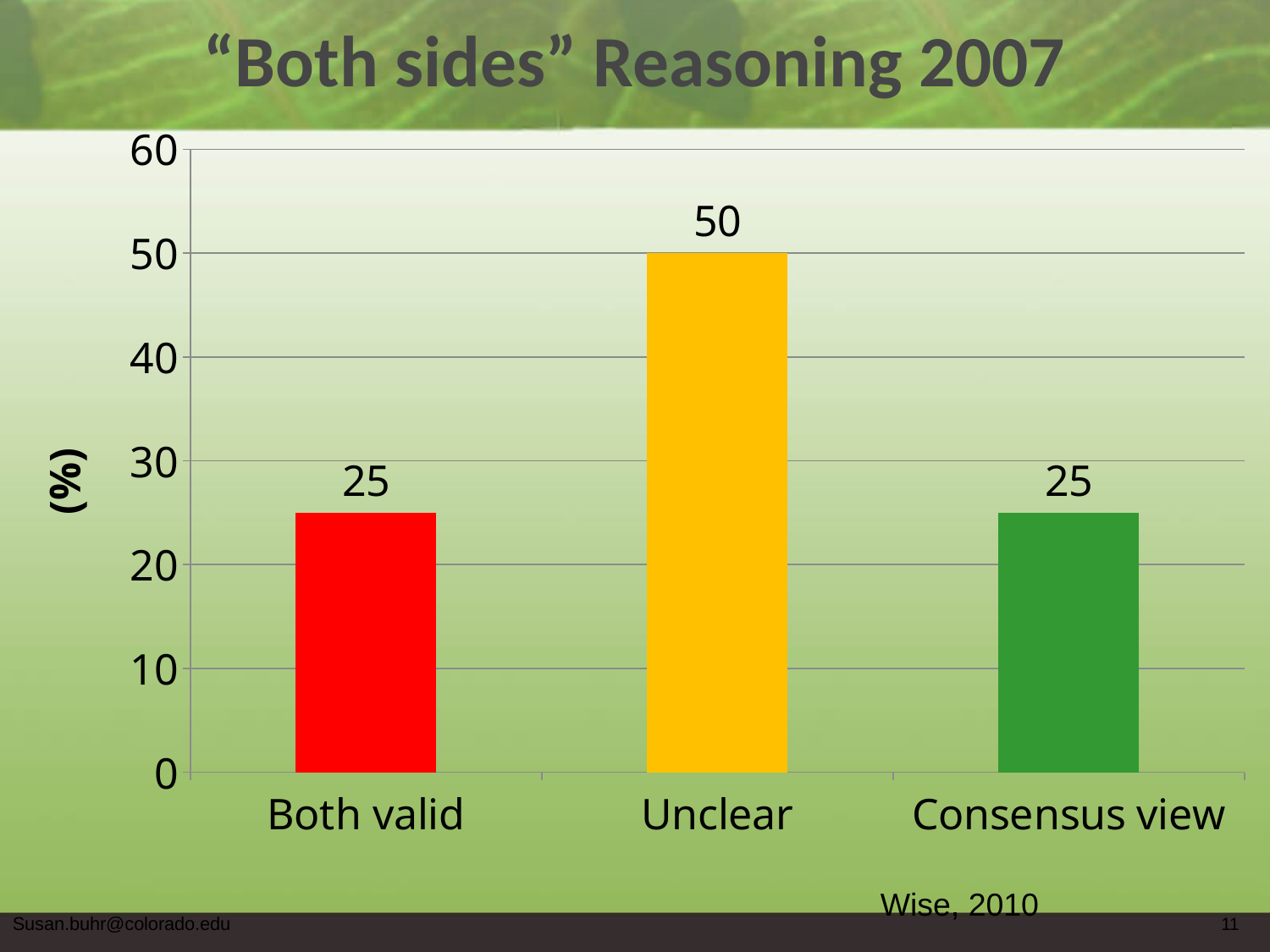
Which is larger, the value for Unclear or the value for Consensus view? Unclear What is the title of the chart? "Both sides" Reasoning 2007 How many categories are shown on the x axis? 3 What is the value for Unclear? 50 Is the value for Unclear greater or less than 40? greater What kind of chart is shown on the slide? bar chart Which category has the highest value? Unclear What is the value for Both valid? 25 Is the value for Both valid greater or less than 30? less What is the value for Consensus view? 25 What is the difference between the values for Unclear and Both valid? 25 What colour is the bar for Unclear? yellow